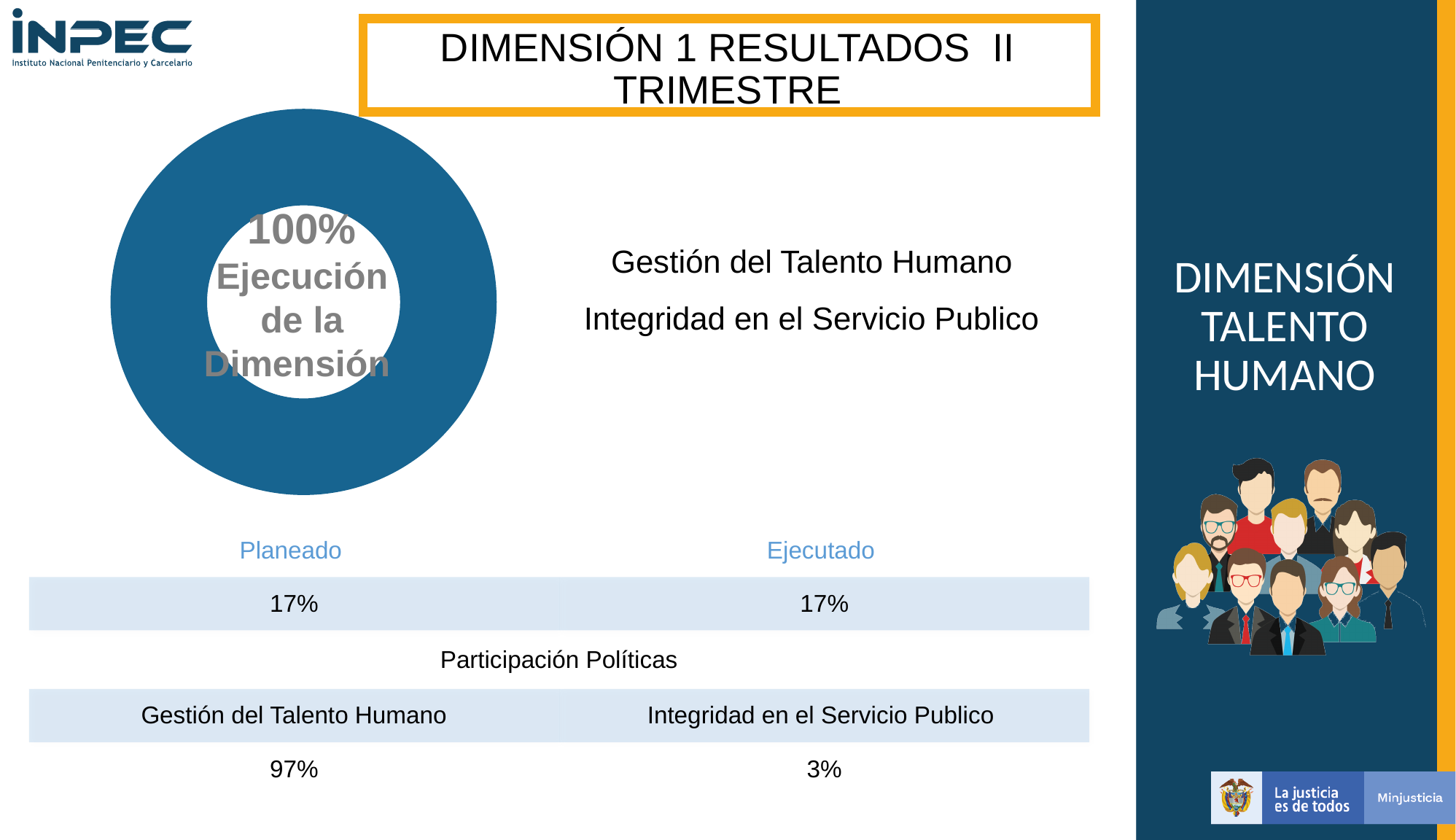
What does the text in the centre of the doughnut chart say the 100% represents? Ejecución de la Dimensión How many distinct slices does the doughnut chart show? 1 What kind of chart is shown on the left of the slide? Doughnut chart What share of the doughnut chart does the single slice occupy? 100% What colour is the ring of the doughnut chart? Blue What percentage is shown in the centre of the doughnut chart? 100%